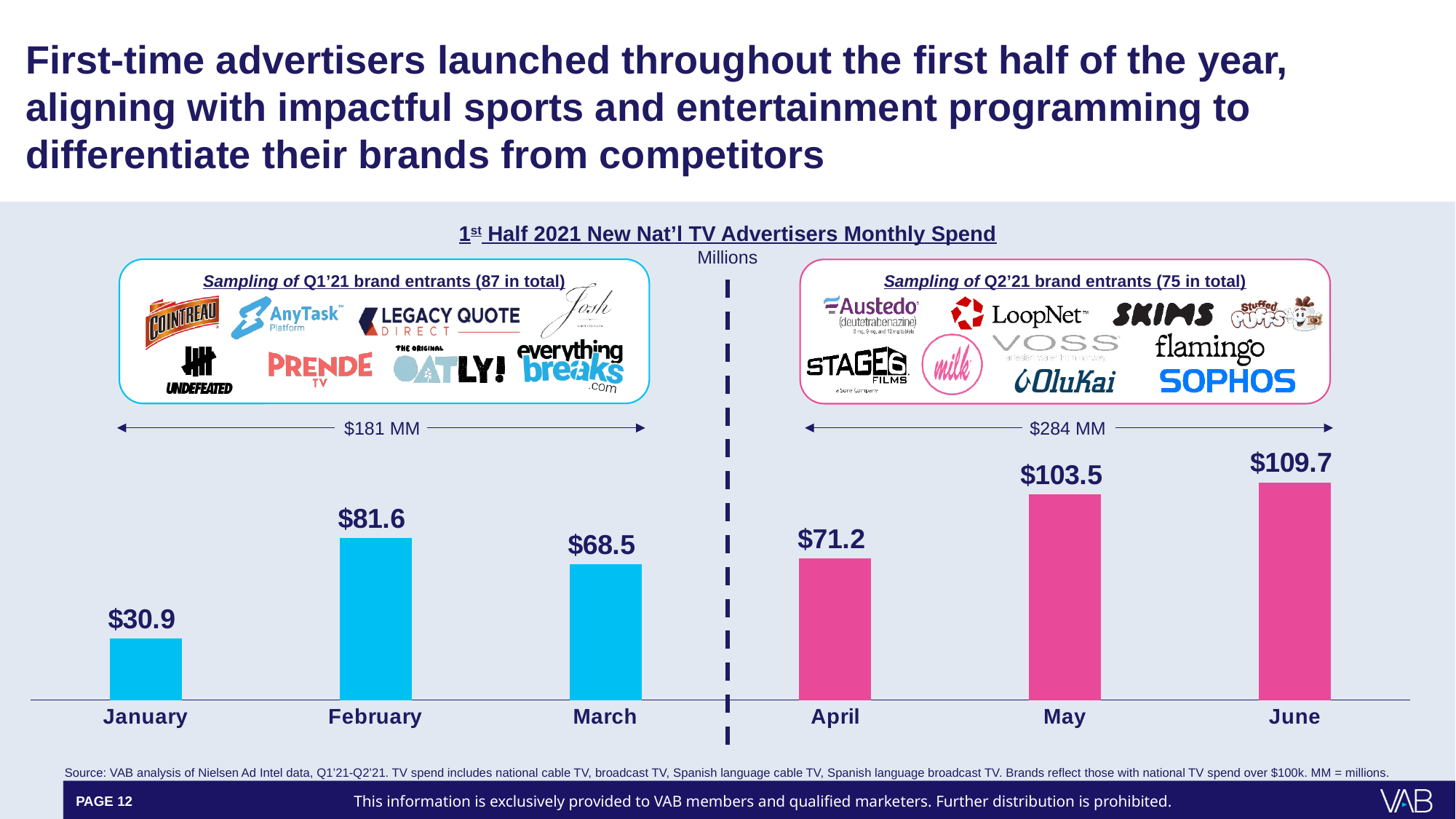
How many months are plotted in the chart? 6 What is the monthly spend shown for May? $103.5 Which month has the lowest spend in the chart? January Do the spend values rise or fall from April to June? Rise What is the total spend shown for the Q1'21 months (January through March)? $181 MM What is the title of the chart? 1st Half 2021 New Nat'l TV Advertisers Monthly Spend What is the difference between the spend for February and the spend for March? $13.1 What kind of chart is shown on the slide? Bar chart What is the difference between the spend for June and the spend for April? $38.5 Which month has the larger spend, March or April? April What is the monthly spend shown for January? $30.9 Which month has the highest spend in the chart? June